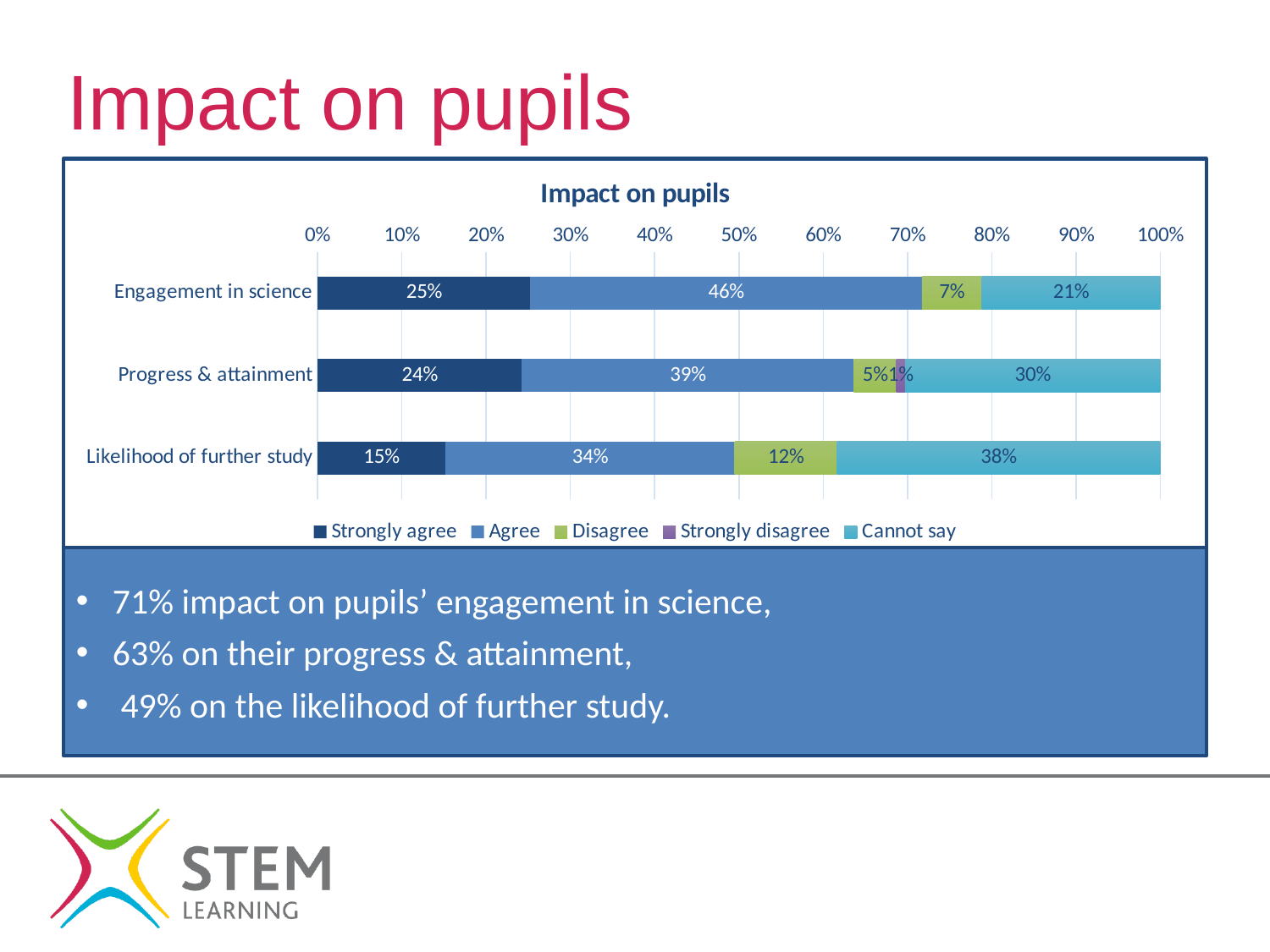
What is the combined Strongly agree and Agree value for Engagement in science? 71% Which category has the lowest Agree value? Likelihood of further study What is the Cannot say value for Likelihood of further study? 38% How many series does the legend list? 5 What is the difference between the Cannot say values for Likelihood of further study and Engagement in science? 17% What is the Disagree value for Likelihood of further study? 12% What type of chart is shown on the slide? Stacked bar chart What is the Agree value for Progress & attainment? 39% Which category has the highest Strongly agree value? Engagement in science What is the Strongly agree value for Engagement in science? 25% Which is larger: the Disagree value for Engagement in science or for Progress & attainment? Engagement in science How many categories are plotted on the chart? 3